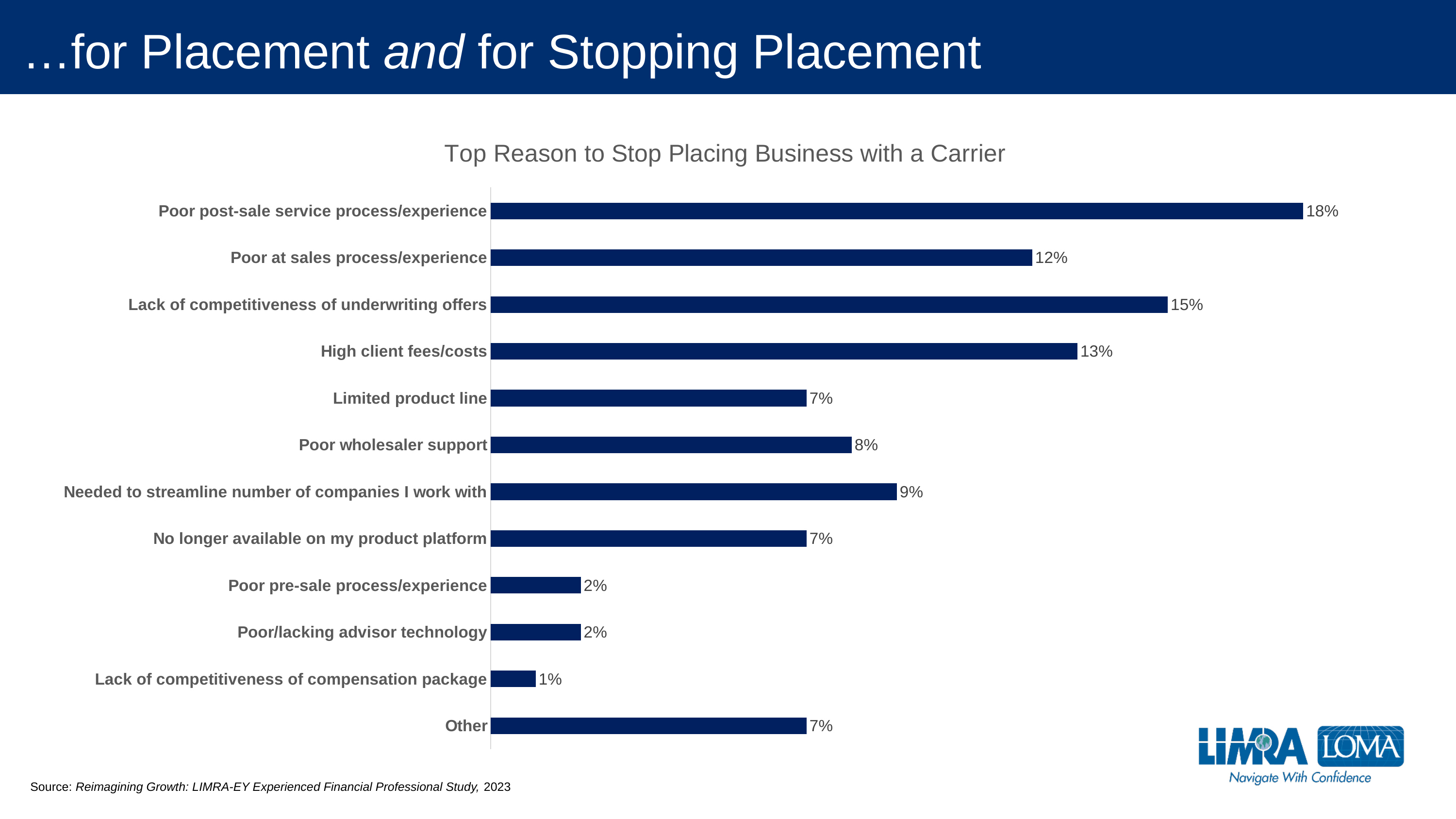
How many categories are shown in the chart? 12 What is the value for Needed to streamline number of companies I work with? 9% Which category has the lowest value? Lack of competitiveness of compensation package What is the value for Lack of competitiveness of underwriting offers? 15% What is the value for Poor post-sale service process/experience? 18% What is the difference between Poor post-sale service process/experience and Poor at sales process/experience? 6% Which category has the highest value? Poor post-sale service process/experience What kind of chart is shown on the slide? Bar chart What is the difference between High client fees/costs and Limited product line? 6% Which is larger, Lack of competitiveness of underwriting offers or High client fees/costs? Lack of competitiveness of underwriting offers What is the value for Poor wholesaler support? 8% What is the title of the chart? Top Reason to Stop Placing Business with a Carrier